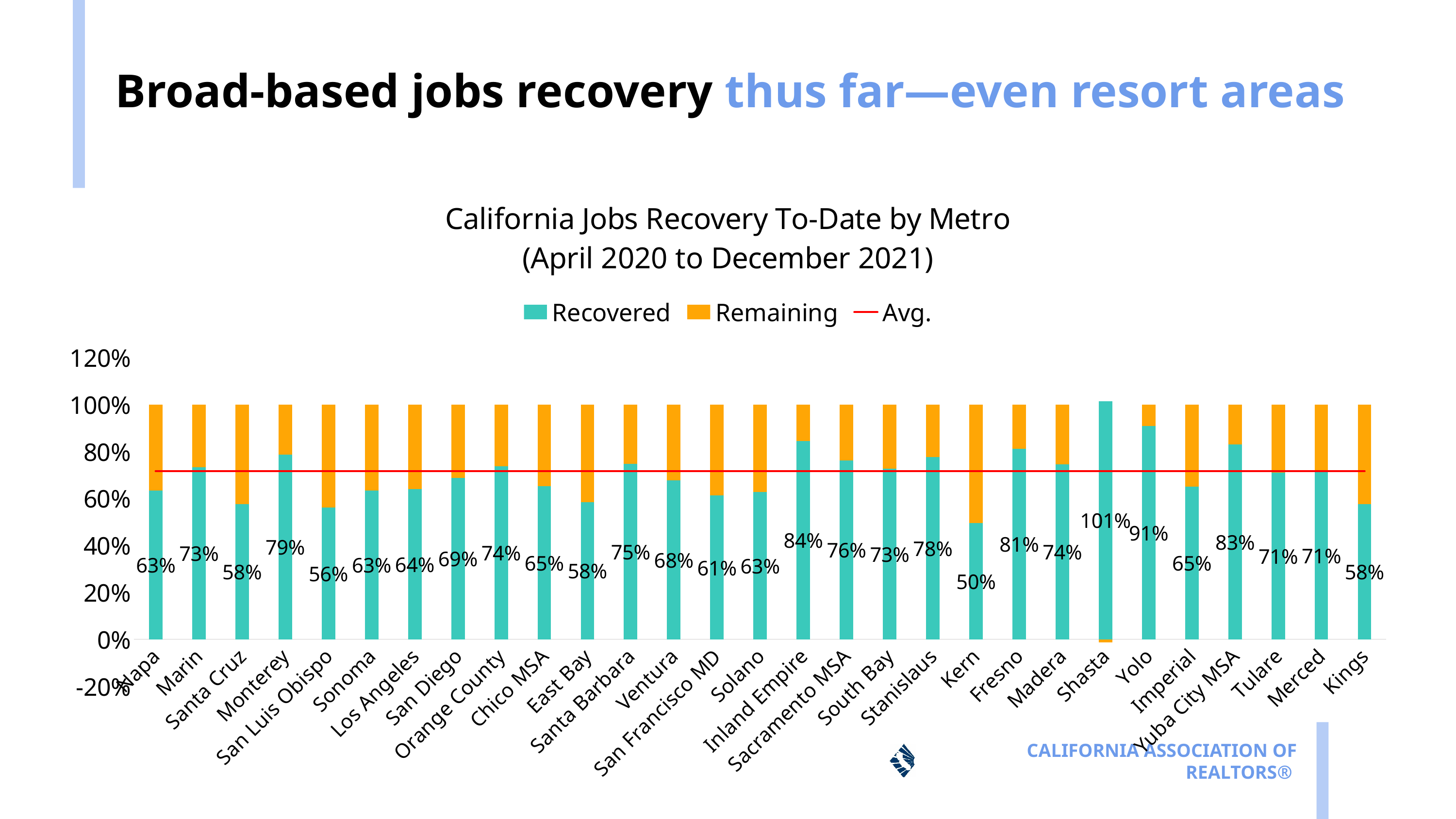
Which metro has the lowest Recovered value? Kern What kind of chart is shown on the slide? Stacked bar chart What is the Recovered value for Yuba City MSA? 83% Which metro has the highest Recovered value? Shasta Which has a higher Recovered value, Monterey or Marin? Monterey Is the Recovered value for Yolo greater or less than 80%? greater How many metros are shown on the x axis? 29 What is the Recovered value for Kern? 50% How many series does the legend list? 3 What is the difference between the Recovered values for Yolo and Imperial? 26% What is the Recovered value for Inland Empire? 84% What is the difference between the Recovered values for Shasta and Kern? 51%